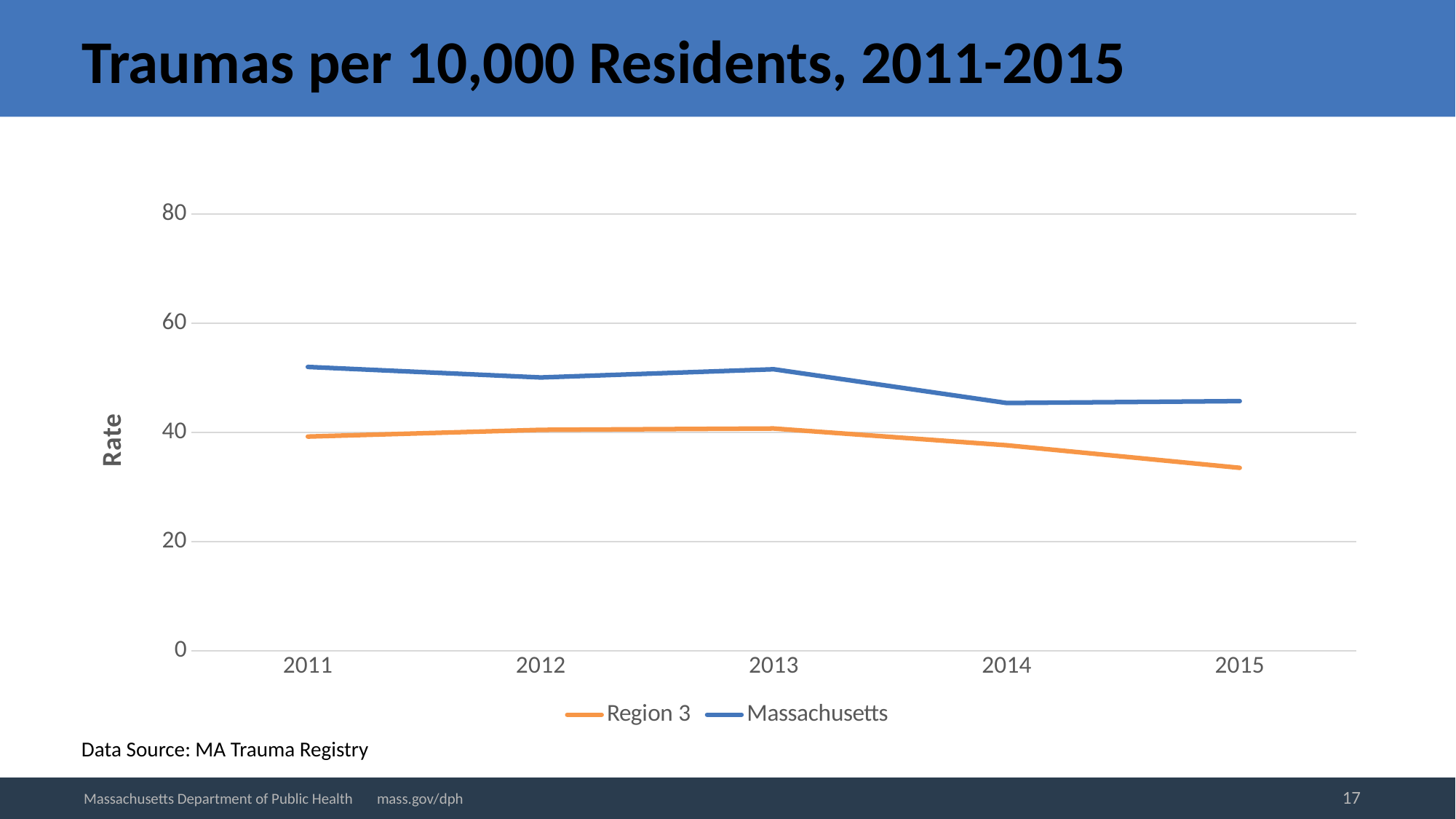
Does the Region 3 rate rise or fall from 2013 to 2015? fall What colour is the Region 3 line? orange Is the value for Massachusetts in 2014 greater or less than 60? less How many series does the legend list? 2 How many years are plotted along the x axis? 5 What is the title of the chart? Traumas per 10,000 Residents, 2011-2015 Which series has the higher value in 2011, Region 3 or Massachusetts? Massachusetts In which year is the Region 3 rate lowest? 2015 Which series has the higher value in 2015, Region 3 or Massachusetts? Massachusetts Is the value for Massachusetts in 2011 greater or less than 40? greater What kind of chart is shown on the slide? line chart Is the value for Region 3 in 2015 greater or less than 40? less